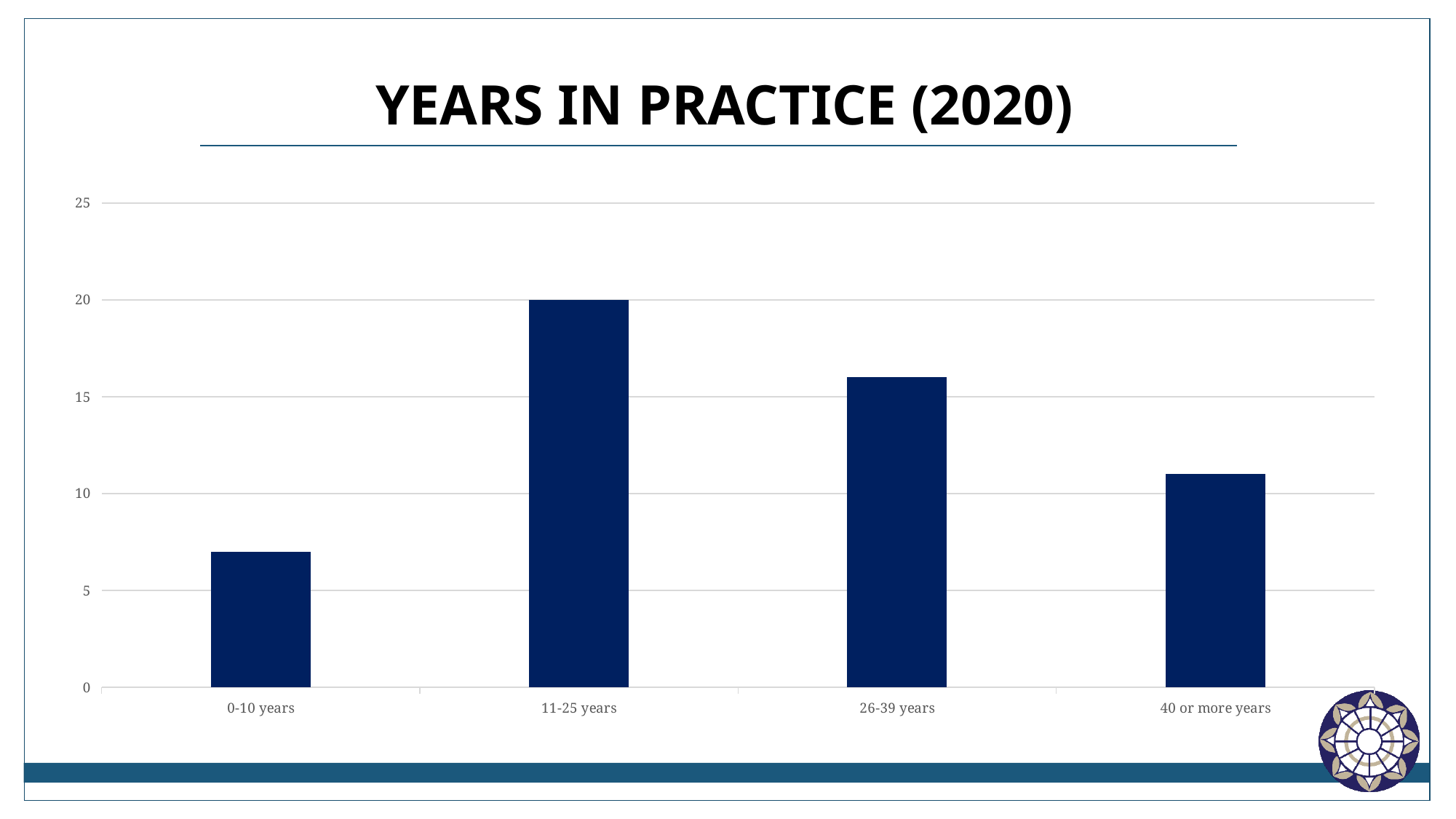
Is the value for 26-39 years greater or less than 15? greater Which category has the highest value? 11-25 years How many categories are shown on the x axis? 4 What is the title of the chart? YEARS IN PRACTICE (2020) What is the value for 11-25 years? 20 Which is larger, the value for 0-10 years or the value for 40 or more years? 40 or more years Which is larger, the value for 26-39 years or the value for 40 or more years? 26-39 years Which category has the lowest value? 0-10 years Is the value for 0-10 years greater or less than 5? greater What kind of chart is shown on the slide? bar chart Is the value for 0-10 years greater or less than 10? less